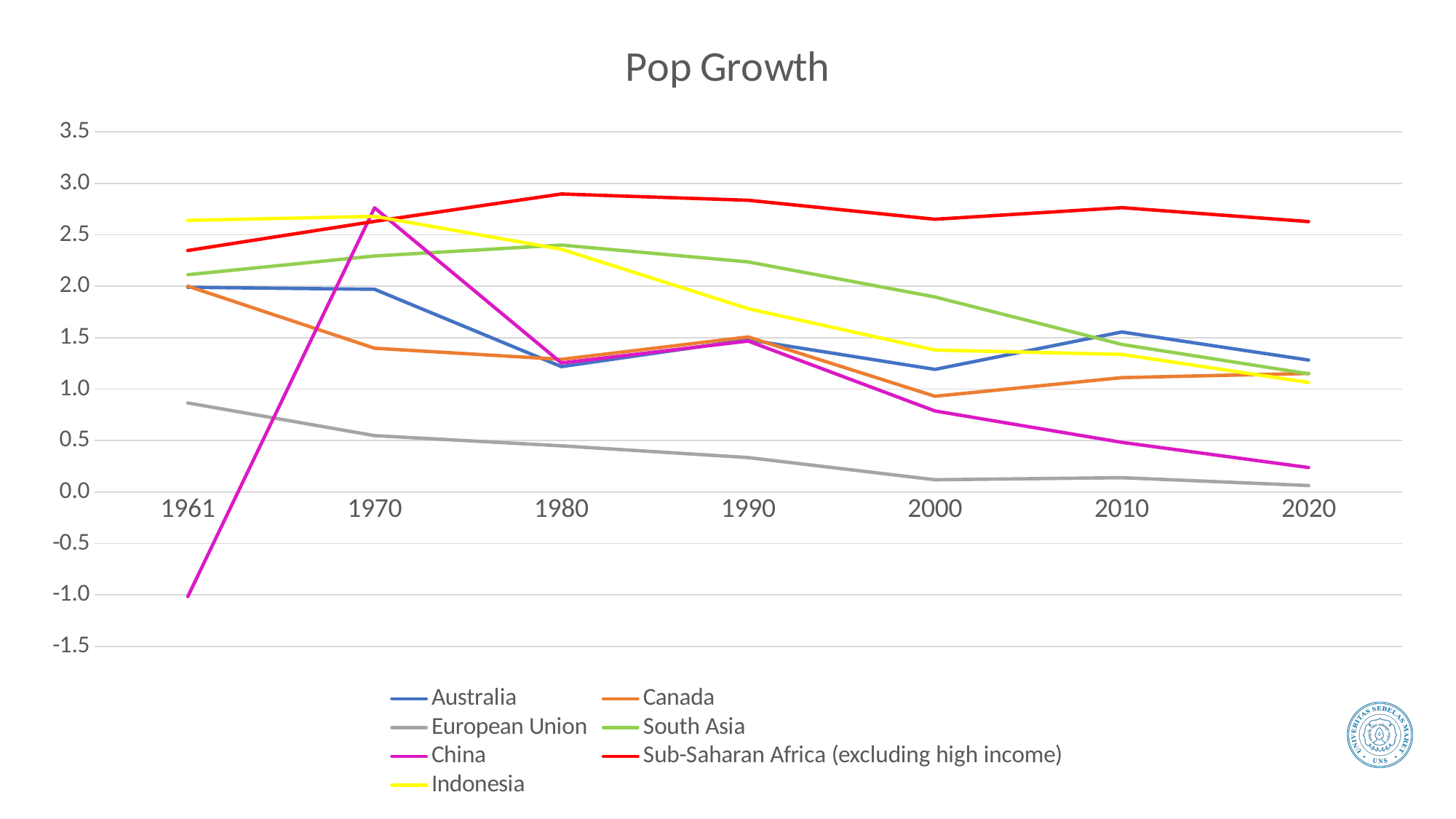
How many years are shown on the x axis? 7 Which series has the lowest value in 2020? European Union Which series has the highest value in 2020? Sub-Saharan Africa (excluding high income) Does the European Union line rise or fall from 1961 to 2020? fall How many series does the legend list? 7 What kind of chart is shown on the slide? line chart Which series is drawn in red? Sub-Saharan Africa (excluding high income) Is the value for Sub-Saharan Africa (excluding high income) in 1980 greater or less than 2.5? greater Is the value for China in 1961 greater or less than 0.0? less Which series has the lowest value in 1961? China What is the title of the chart? Pop Growth Is the value for Indonesia in 2020 greater or less than 1.5? less